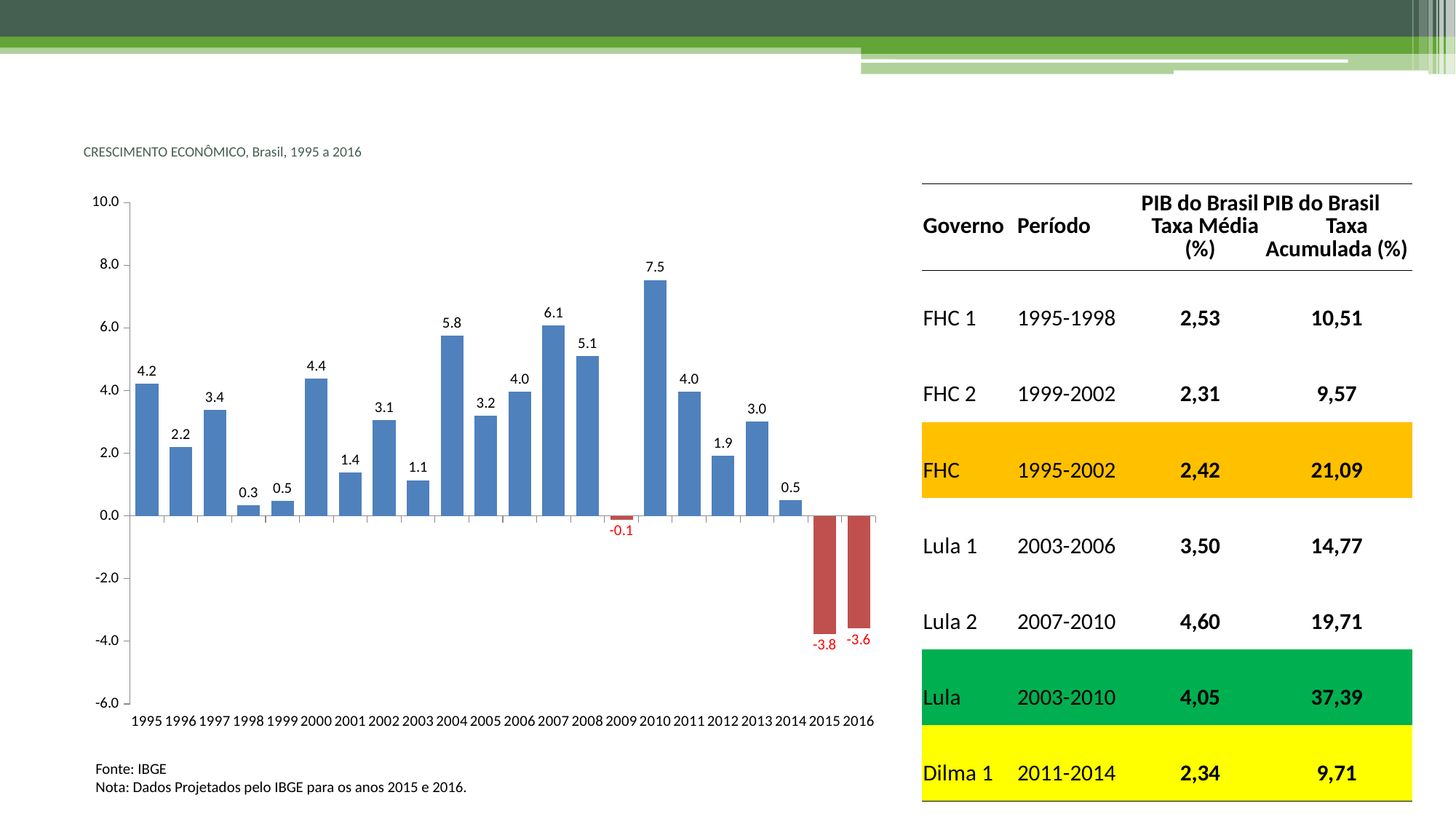
What is the title of the chart? CRESCIMENTO ECONÔMICO, Brasil, 1995 a 2016 What is the difference between the values for 2007 and 2008? 1.0 What is the value for 2010 in the chart? 7.5 Which year has the lowest value in the chart? 2015 How many years are shown on the x axis of the chart? 22 Do the values rise or fall from 2013 to 2016? fall What kind of chart is shown on the slide? bar chart Which year has the highest value in the chart? 2010 Is the value for 2007 greater or less than 6.0? greater What is the value for 2015 in the chart? -3.8 What is the value for 1998 in the chart? 0.3 Which is larger, the value for 2004 or the value for 2011? 2004